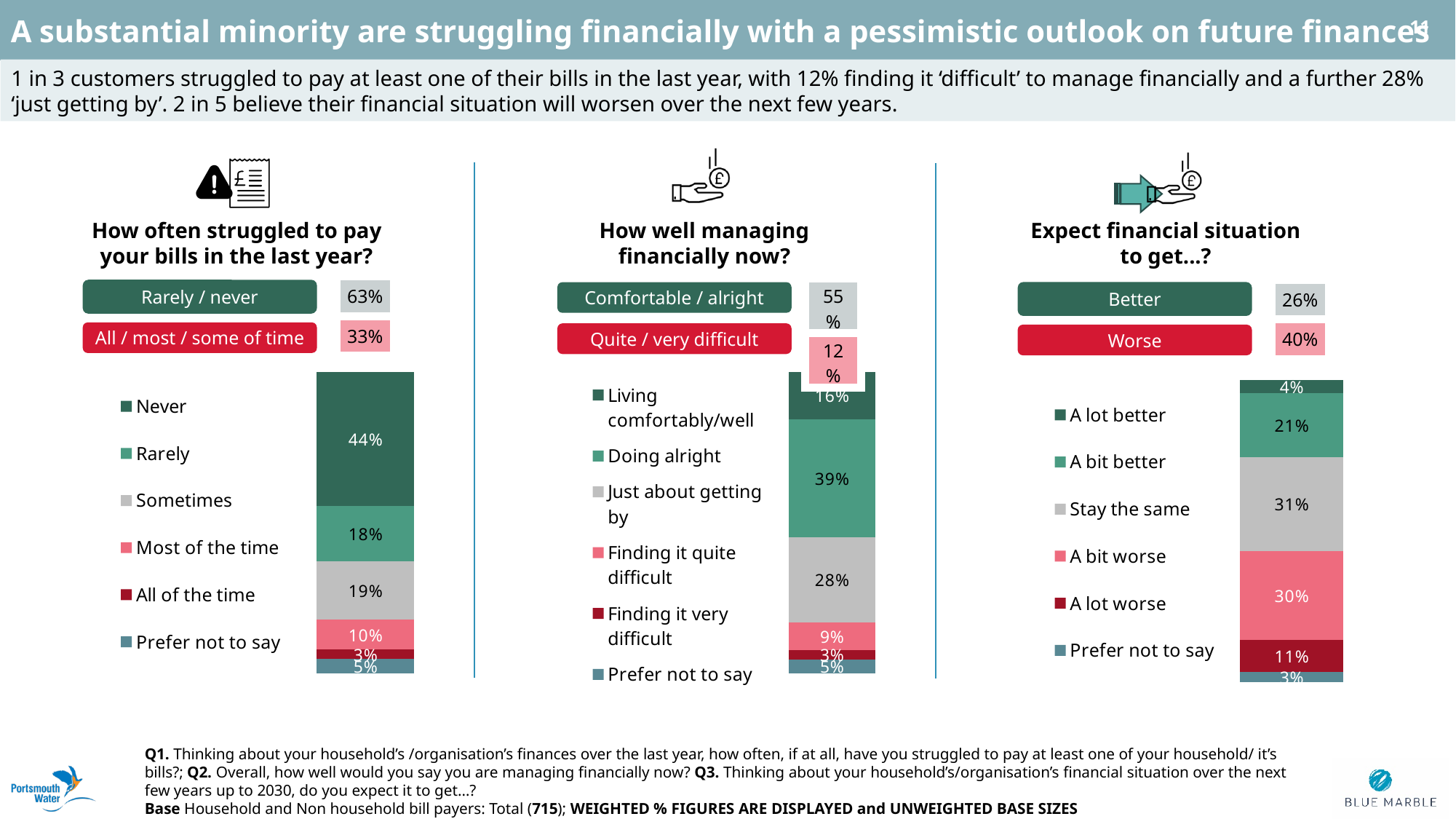
In the chart 'How well managing financially now?', what percentage are 'Finding it quite difficult'? 9% In the chart 'How well managing financially now?', how many categories does the legend list? 6 In the chart 'How often struggled to pay your bills in the last year?', which category has the highest value? Never In the chart 'Expect financial situation to get...?', what is the combined total of 'A bit worse' and 'A lot worse'? 41% In the chart 'How well managing financially now?', what percentage are 'Doing alright'? 39% In the chart 'Expect financial situation to get...?', which is larger: 'A bit better' or 'A bit worse'? A bit worse In the chart 'How well managing financially now?', which category has the lowest value? Finding it very difficult In the chart 'How often struggled to pay your bills in the last year?', what is the difference between 'Rarely' and 'Most of the time'? 8% In the chart 'Expect financial situation to get...?', what percentage expect it to 'Stay the same'? 31% What type of chart is used in the 'Expect financial situation to get...?' panel? Stacked bar chart In the chart 'How often struggled to pay your bills in the last year?', what percentage answered 'Sometimes'? 19% In the chart 'How often struggled to pay your bills in the last year?', what percentage of respondents answered 'Never'? 44%